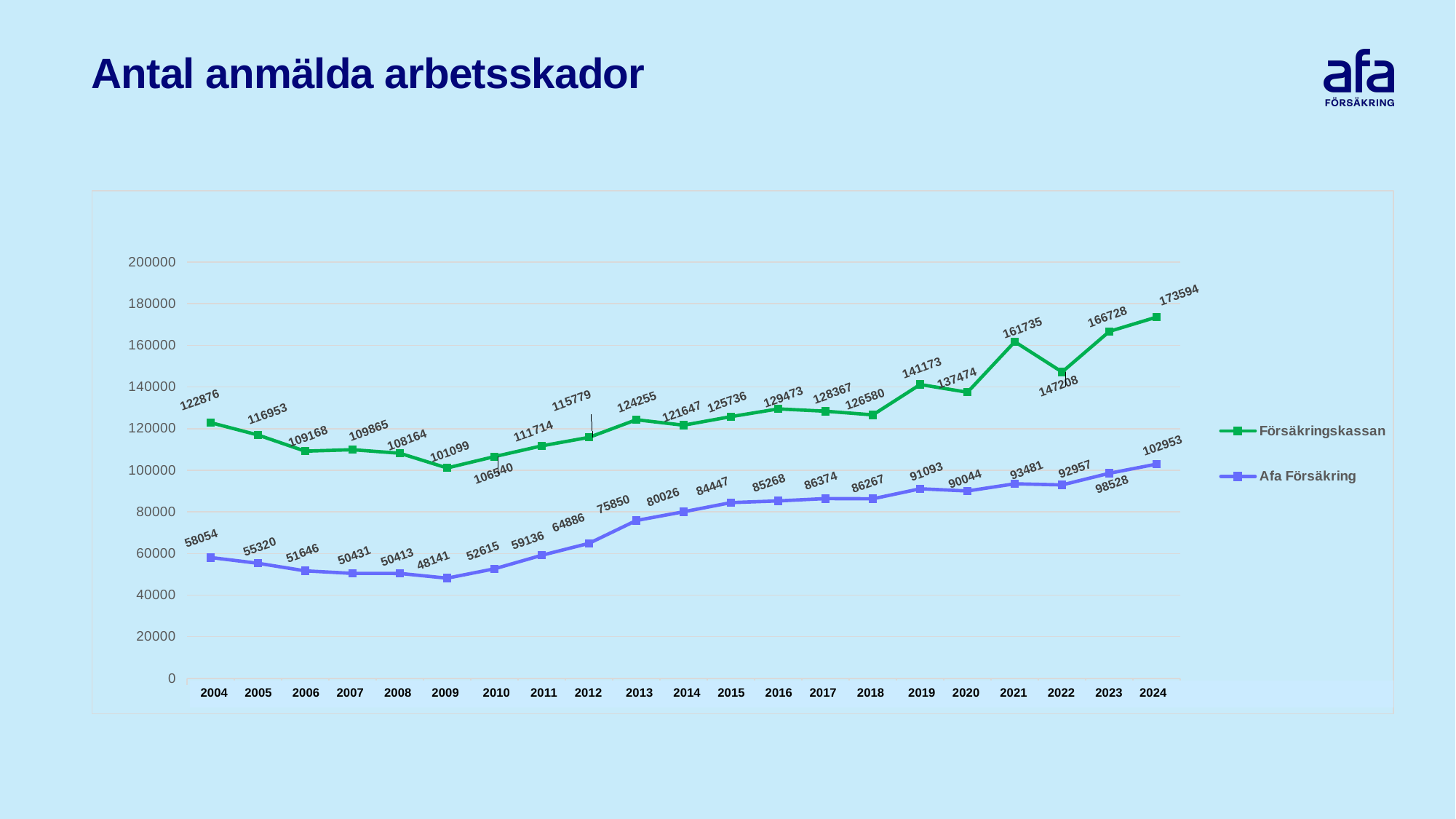
How many series does the legend list? 2 Which is larger for Försäkringskassan: the value in 2021 or the value in 2022? 2021 Is the value for Afa Försäkring in 2013 greater or less than 80000? less In which year is the Försäkringskassan series at its lowest? 2009 What is the value for Försäkringskassan in 2024? 173594 What kind of chart is shown on the slide? line chart By how much did the Afa Försäkring value increase from 2023 to 2024? 4425 What is the value for Försäkringskassan in 2021? 161735 How many years are shown on the x axis? 21 What is the difference between Försäkringskassan and Afa Försäkring in 2024? 70641 In which year is the Afa Försäkring series at its highest? 2024 What is the value for Afa Försäkring in 2009? 48141